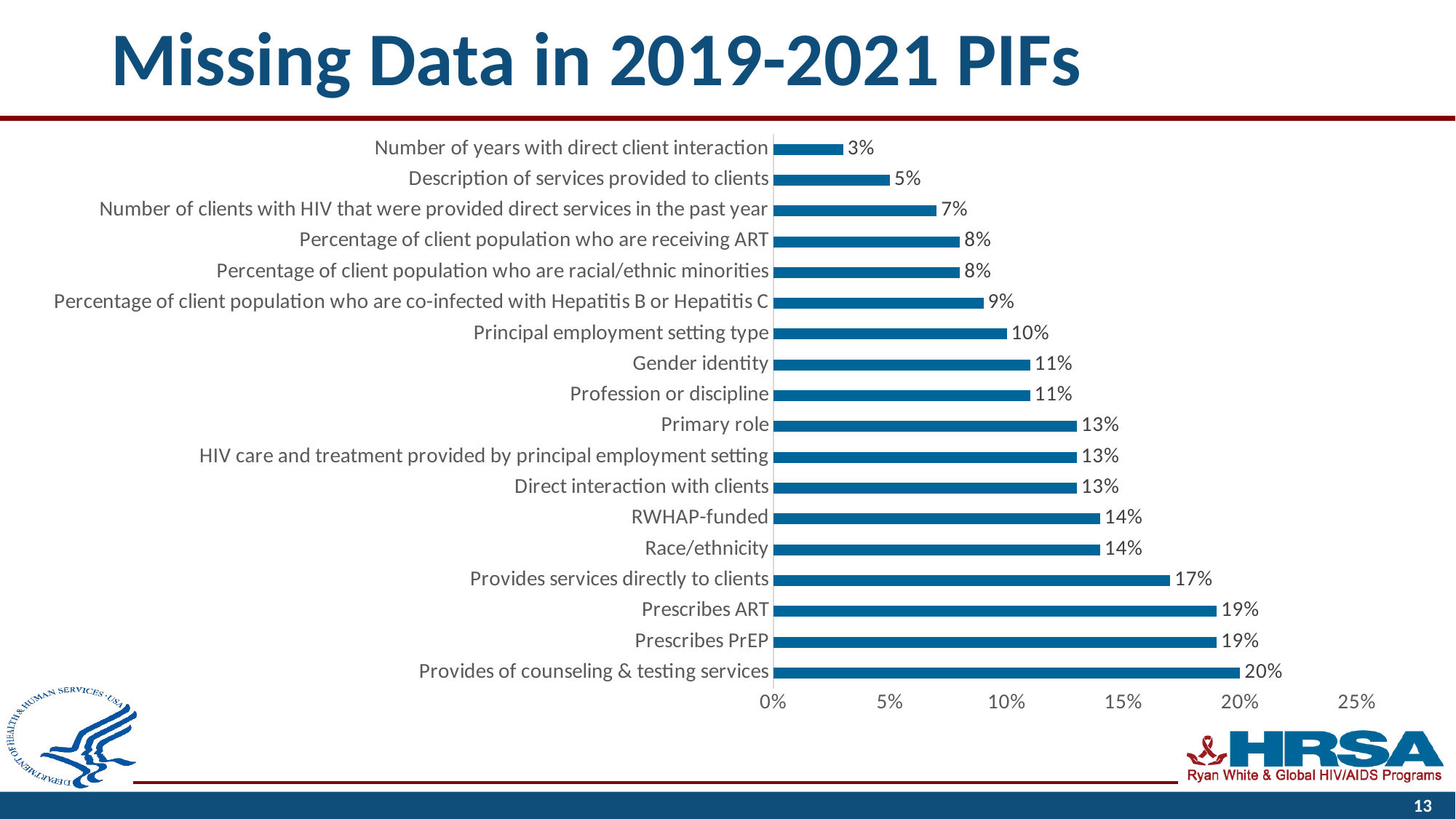
Which category has the lowest missing data percentage? Number of years with direct client interaction How many categories are shown in the chart? 18 Is the value for Prescribes PrEP greater or less than 15%? greater What is the title of the slide? Missing Data in 2019-2021 PIFs Which has a larger value, RWHAP-funded or Principal employment setting type? RWHAP-funded What is the difference between the values for Prescribes ART and Primary role? 6% What type of chart is shown on the slide? Bar chart Which category has the highest missing data percentage? Provides of counseling & testing services What is the missing data percentage for Gender identity? 11% What is the maximum value shown on the x axis? 25% What is the value shown for Race/ethnicity? 14% What percentage is shown for Provides services directly to clients? 17%